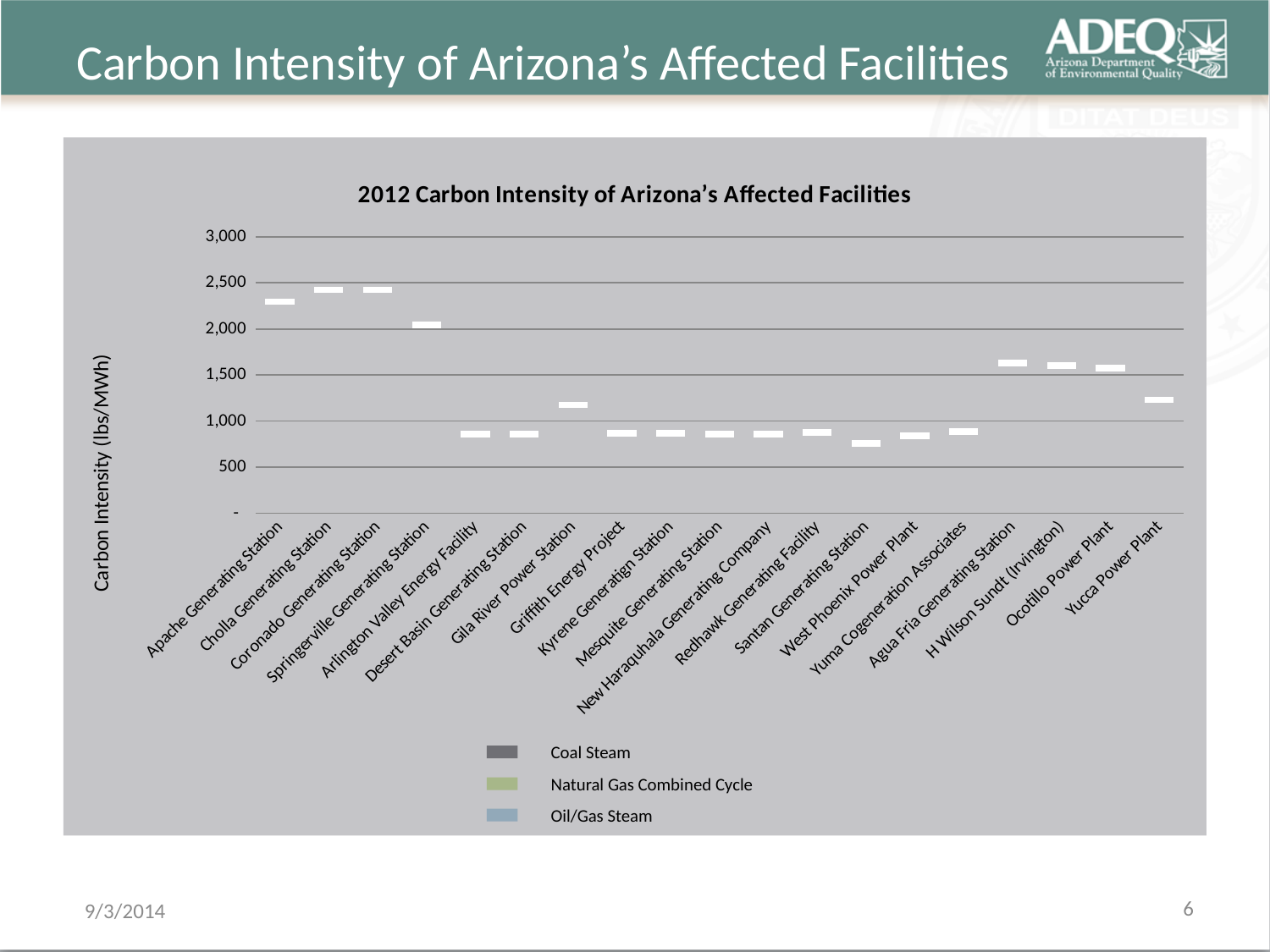
Is the value for Cholla Generating Station greater or less than 2,500? less Which has the higher carbon intensity, Springerville Generating Station or Ocotillo Power Plant? Springerville Generating Station How many series does the legend list? 3 Which has the higher carbon intensity, Apache Generating Station or Arlington Valley Energy Facility? Apache Generating Station What is the title of the chart? 2012 Carbon Intensity of Arizona's Affected Facilities Is the value for Gila River Power Station greater or less than 1,000? greater What is the label on the vertical axis? Carbon Intensity (lbs/MWh) How many facilities are shown on the x axis? 19 Is the value for Yucca Power Plant greater or less than 1,500? less